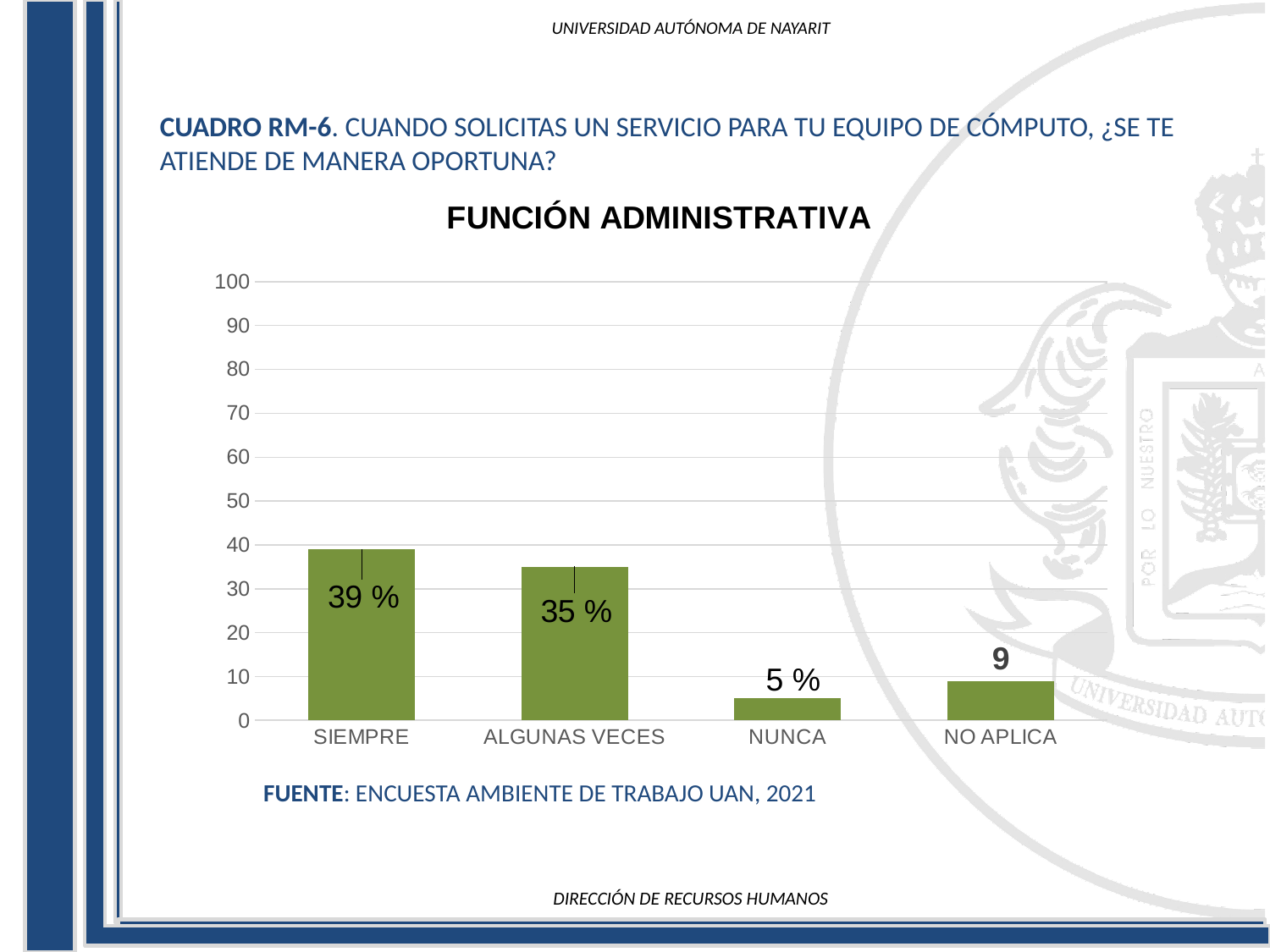
Is the value for SIEMPRE greater or less than 30? greater Which category has the lowest value? NUNCA How many categories are shown on the x axis? 4 What is the value for ALGUNAS VECES? 35 % What is the value for NUNCA? 5 % What is the difference between the values for SIEMPRE and ALGUNAS VECES? 4 % What is the value for SIEMPRE? 39 % What is the title of the chart? FUNCIÓN ADMINISTRATIVA What is the data label shown for NO APLICA? 9 Which is larger, the value for ALGUNAS VECES or the value for NUNCA? ALGUNAS VECES What kind of chart is shown? bar chart Which category has the highest value? SIEMPRE